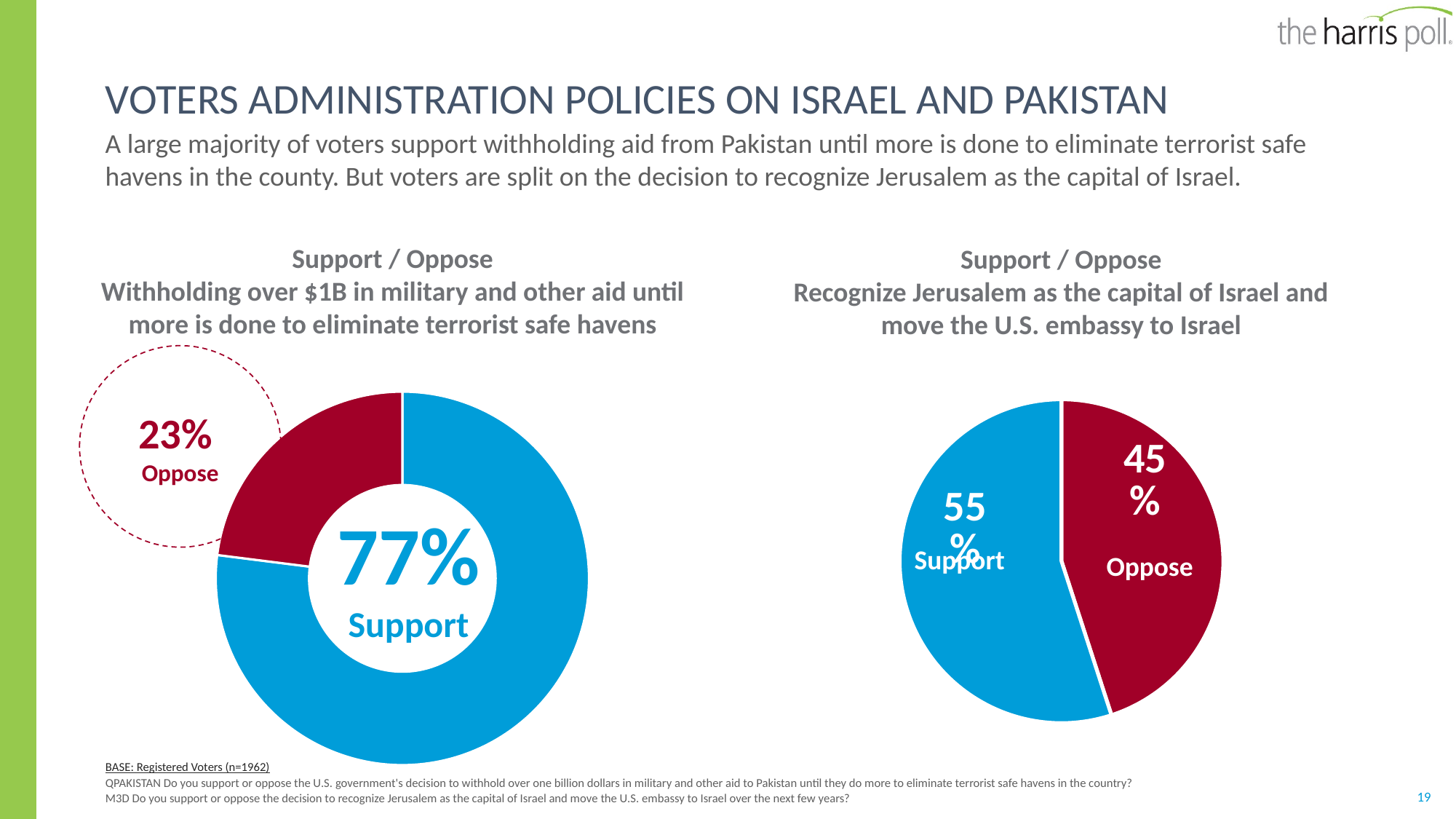
In the right chart (recognize Jerusalem as the capital of Israel), which response has the smaller share? Oppose In the right chart (recognize Jerusalem as the capital of Israel), what colour is the Oppose slice? Red In the left chart (withholding aid from Pakistan), which response has the larger share, Support or Oppose? Support What kind of chart is used on the right side of the slide (recognize Jerusalem as the capital of Israel)? Pie chart In the right chart (recognize Jerusalem as the capital of Israel), what is the difference in percentage points between Support and Oppose? 10 percentage points In the right chart (recognize Jerusalem as the capital of Israel), what percentage of voters oppose the decision? 45% In the right chart (recognize Jerusalem as the capital of Israel), what percentage of voters support the decision? 55% How many categories are shown in the left chart (withholding aid from Pakistan)? 2 In the left chart (withholding aid from Pakistan), what percentage of voters support the policy? 77% Is the Support share larger in the left chart (withholding aid from Pakistan) or in the right chart (recognize Jerusalem)? Left chart (withholding aid from Pakistan) In the left chart (withholding aid from Pakistan), what is the difference in percentage points between Support and Oppose? 54 percentage points In the left chart (withholding aid from Pakistan), what percentage of voters oppose the policy? 23%